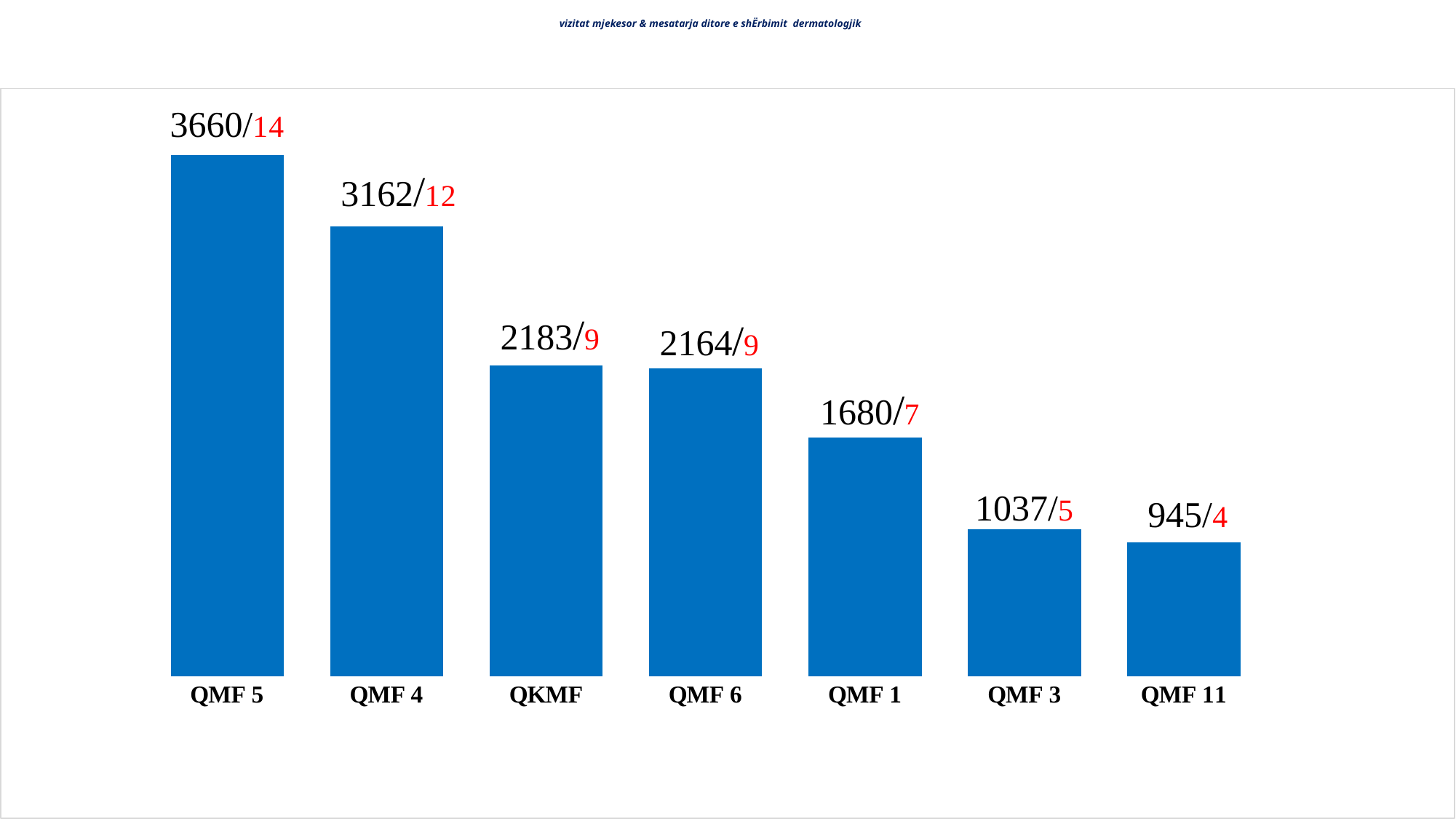
Which category has the shortest bar? QMF 11 What is the data label shown above the bar for QMF 11? 945/4 What is the difference between the first number in the label for QMF 3 (1037) and the first number in the label for QMF 11 (945)? 92 What is the data label shown above the bar for QMF 1? 1680/7 Which bar is taller, QMF 4 or QMF 6? QMF 4 Do the bar heights rise or fall from left to right across the x axis? Fall Which category has the tallest bar? QMF 5 How many categories are shown on the x axis? 7 What is the data label shown above the bar for QKMF? 2183/9 What is the data label shown above the bar for QMF 5? 3660/14 What type of chart is shown on the slide? Bar chart What is the difference between the first number in the label for QMF 5 (3660) and the first number in the label for QMF 4 (3162)? 498